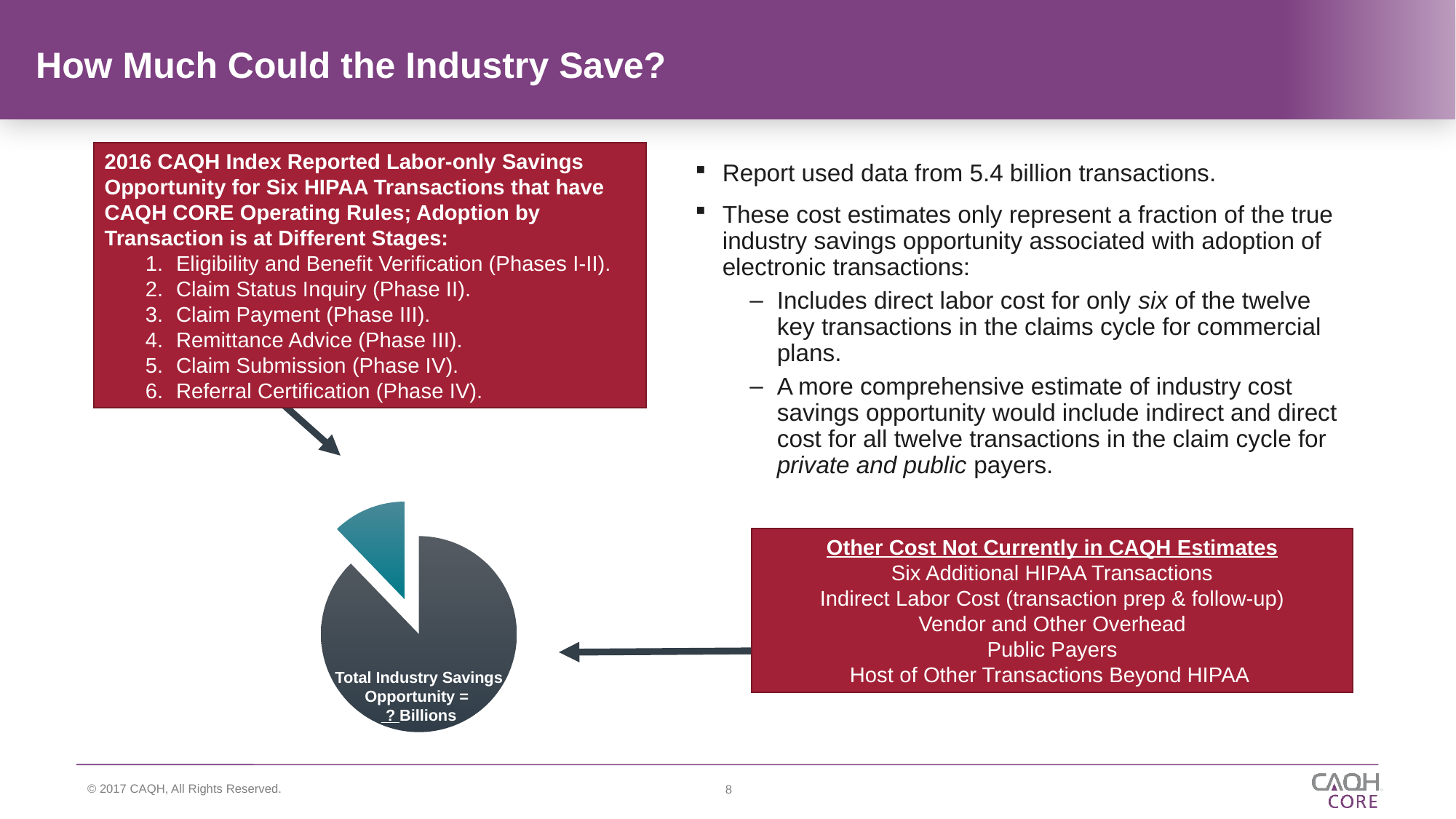
How many slices does the pie chart have? 2 Which slice of the pie chart is the largest? The dark gray slice Which slice of the pie chart is larger, the dark gray slice or the teal slice? The dark gray slice What kind of chart is shown on the slide? Pie chart Which slice of the pie chart is the smallest? The teal slice Which slice of the pie chart is pulled out (exploded) from the rest of the pie? The teal slice What text is printed on the large dark slice of the pie chart? Total Industry Savings Opportunity = ? Billions